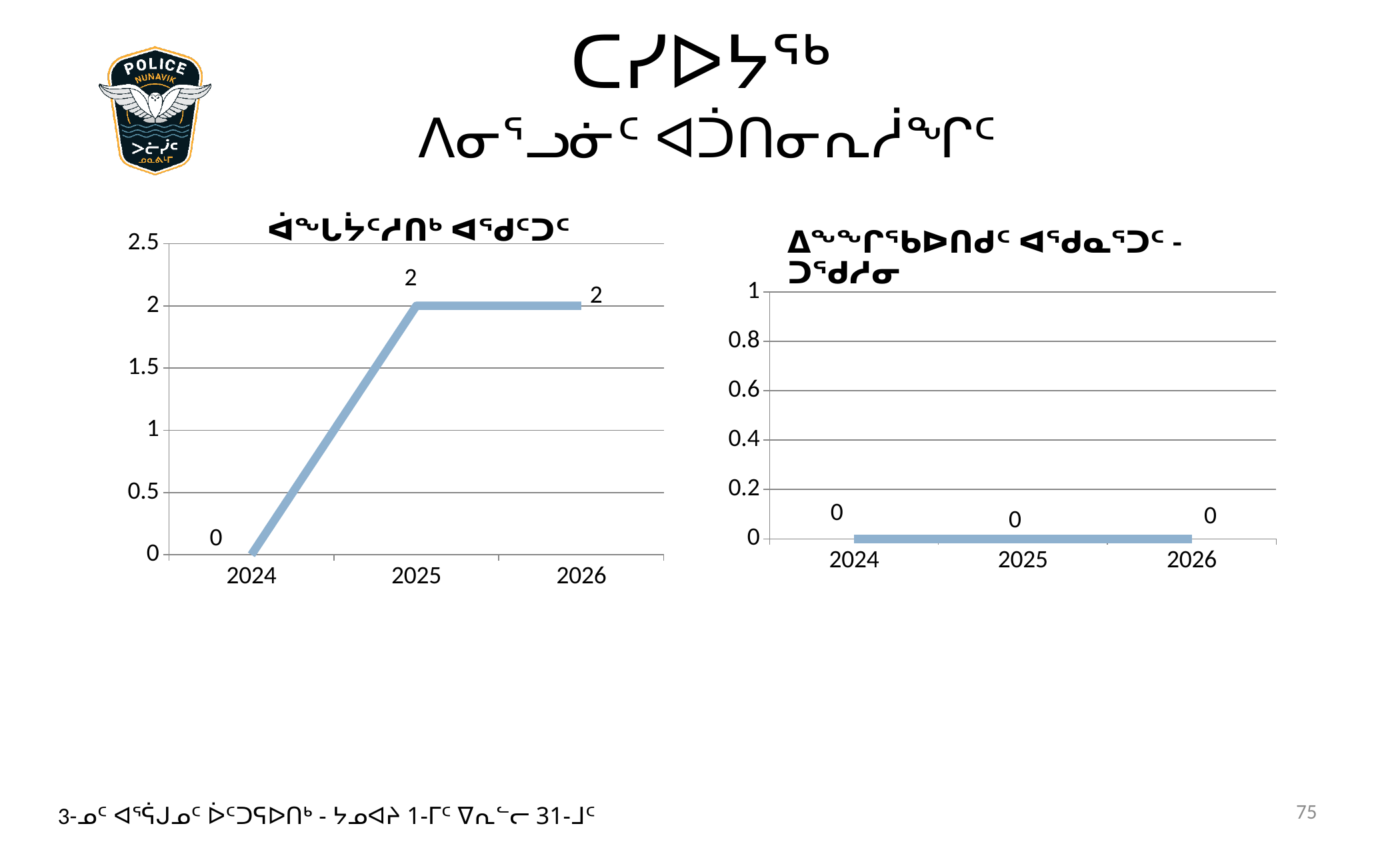
In the left chart, what is the value for 2026? 2 How many years are plotted on the x axis of the right chart? 3 In the left chart, which year has the lowest value? 2024 In the left chart, does the value rise or fall from 2024 to 2025? rise In the left chart, what is the value for 2025? 2 In the left chart, what is the value for 2024? 0 What is the highest tick value on the y axis of the right chart? 1 What kind of chart is the left chart? line chart In the left chart, what is the difference between the values for 2025 and 2024? 2 In the right chart, what is the value for 2025? 0 In the left chart, which is larger, the value for 2024 or the value for 2025? 2025 In the right chart, do the values change across the years 2024 to 2026? no, they stay at 0